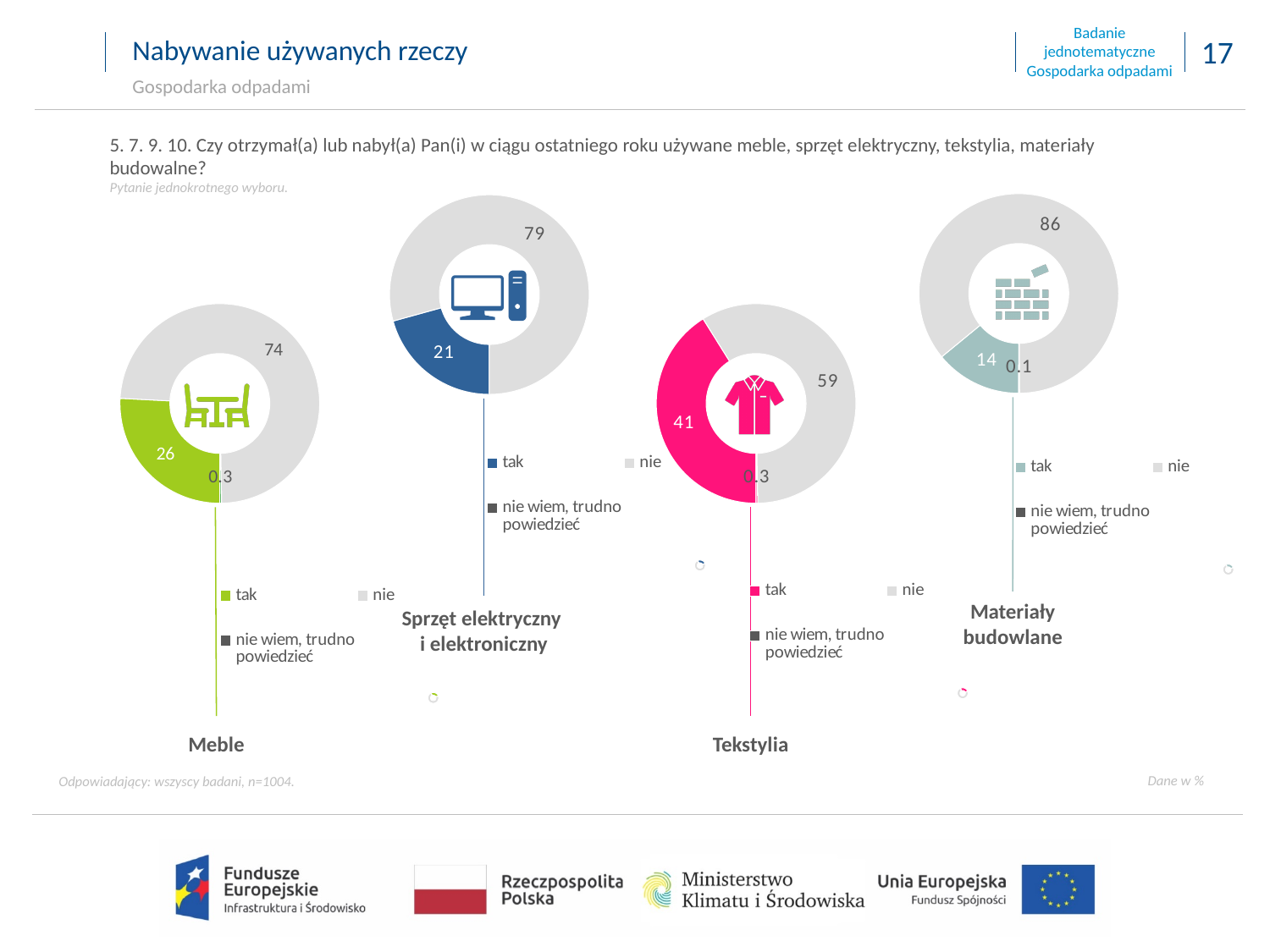
In the Meble chart, what is the value for "tak"? 26 In the Materiały budowlane chart, what is the value for "nie wiem, trudno powiedzieć"? 0.1 In the Tekstylia chart, what is the difference between the "nie" and "tak" values? 18 Which is larger: the "tak" value in the Tekstylia chart or the "tak" value in the Meble chart? Tekstylia How many donut charts are shown on the slide? 4 In the Tekstylia chart, what is the value for "nie"? 59 How many series does the legend of the Tekstylia chart list? 3 In the Meble chart, what is the value for "nie"? 74 In the Meble chart, which category has the lowest value? nie wiem, trudno powiedzieć In the Materiały budowlane chart, which category has the highest value? nie What kind of chart is used for Sprzęt elektryczny i elektroniczny? Donut (pie) chart In the Sprzęt elektryczny i elektroniczny chart, what is the value for "tak"? 21